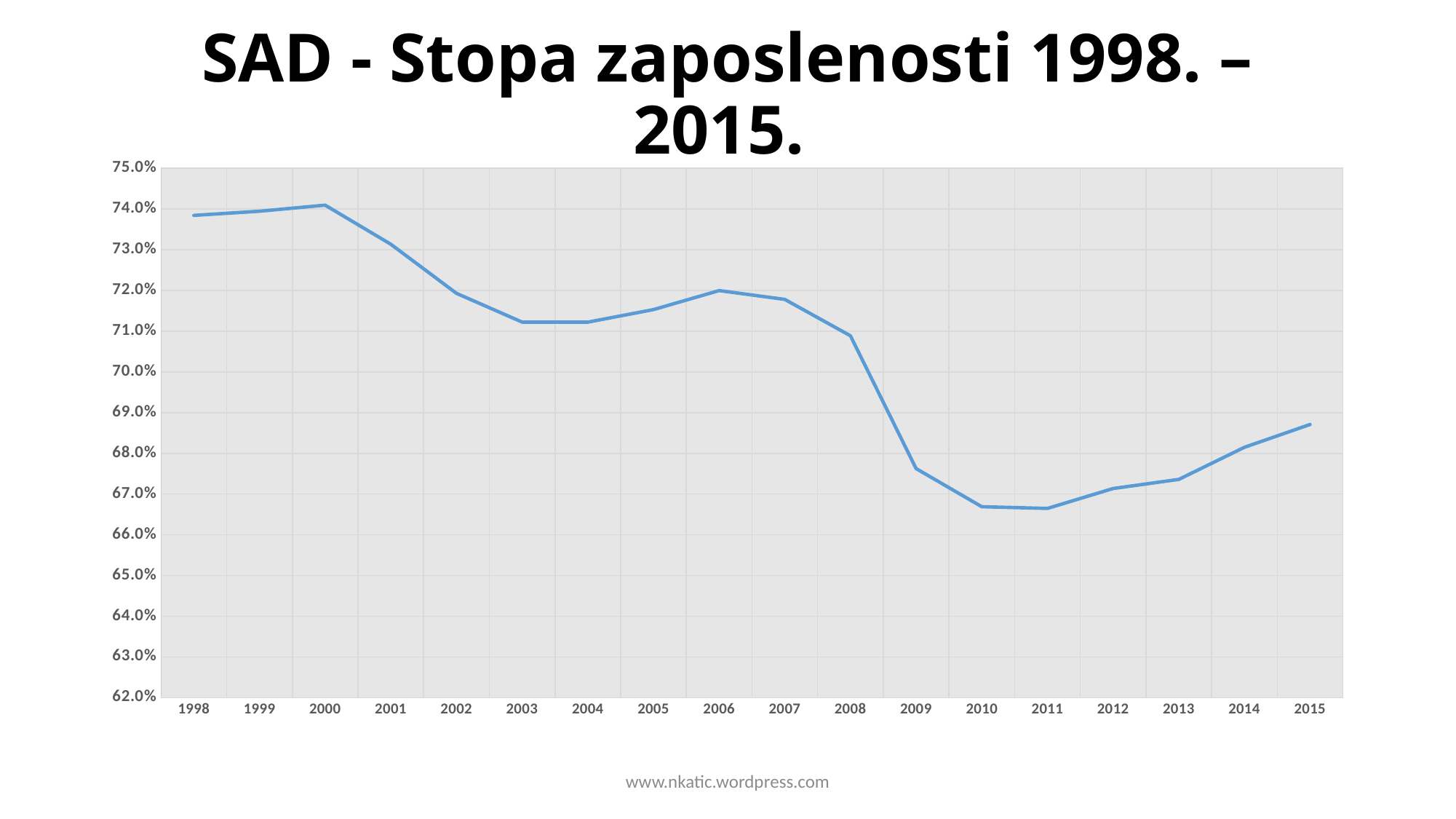
What is the title of the chart? SAD - Stopa zaposlenosti 1998. – 2015. How many years are plotted on the x axis? 18 What kind of chart is shown on the slide? line chart Is the value for 2010 greater or less than 67.0%? less Is the value for 2015 greater or less than 69.0%? less Is the value for 2009 greater or less than 68.0%? less In which year is the employment rate highest? 2000 Which year has the higher employment rate, 2006 or 2009? 2006 Does the employment rate rise or fall from 2011 to 2015? rise Which year has the higher employment rate, 2000 or 2015? 2000